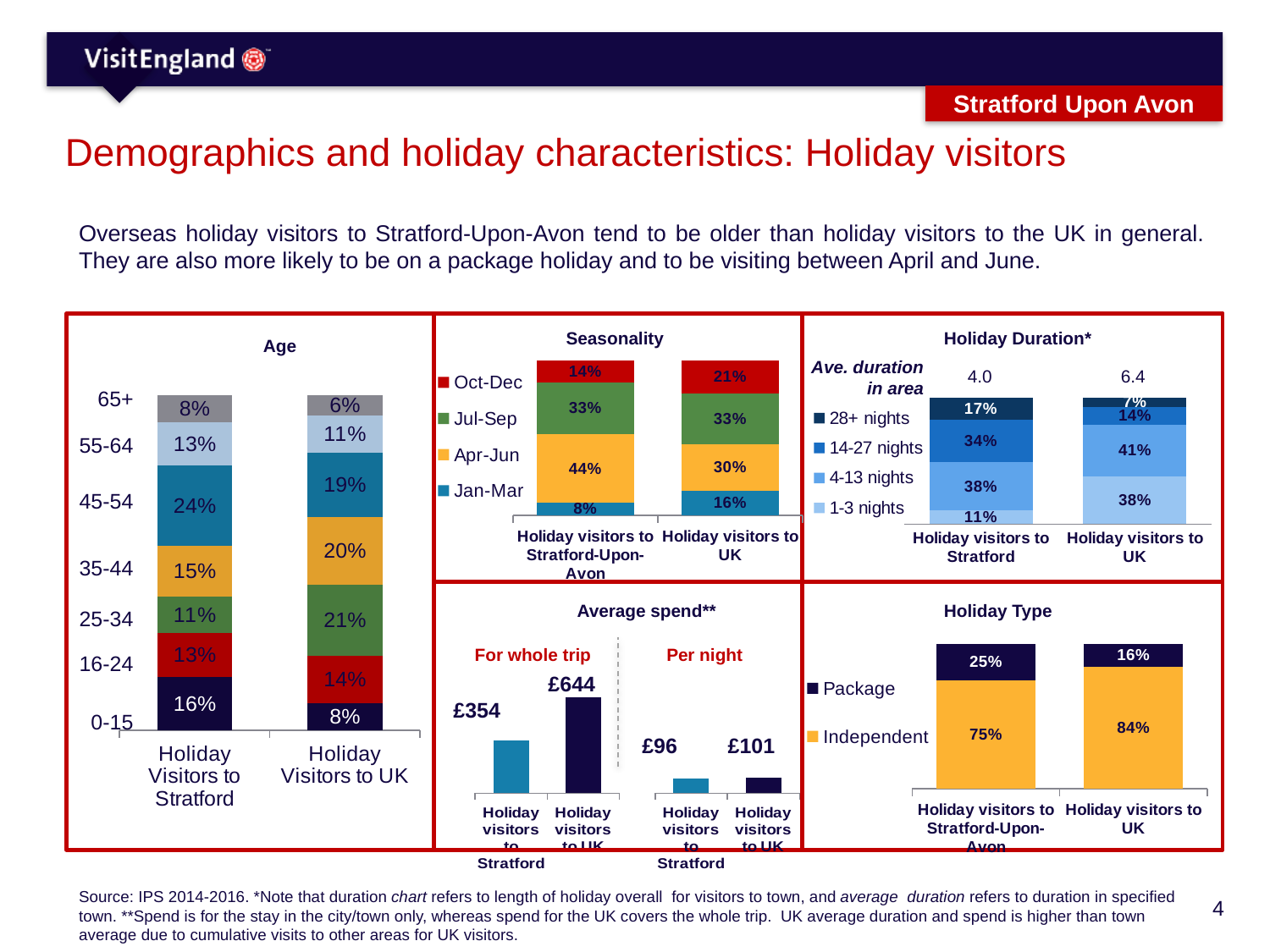
In the Average spend chart, which is larger: the per night spend for holiday visitors to Stratford or for holiday visitors to the UK? Holiday visitors to UK In the Average spend chart, what is the average spend for the whole trip for holiday visitors to the UK? £644 In the Holiday Type chart, what is the difference between the Independent share for holiday visitors to the UK and for holiday visitors to Stratford-Upon-Avon? 9% In the Holiday Duration chart, what share of holiday visitors to the UK stay 4-13 nights? 41% In the Seasonality chart, what share of holiday visitors to Stratford-Upon-Avon visit in Apr-Jun? 44% In the Holiday Duration chart, what is the difference between the 28+ nights share for holiday visitors to Stratford and for holiday visitors to the UK? 10% In the Seasonality chart, how many series does the legend list? 4 What kind of chart is the Age chart? Stacked bar chart In the Seasonality chart, which quarter has the largest share for holiday visitors to Stratford-Upon-Avon? Apr-Jun In the Holiday Type chart, what share of holiday visitors to Stratford-Upon-Avon are on a package holiday? 25% In the Holiday Duration chart, what is the average duration in area for holiday visitors to Stratford? 4.0 In the Seasonality chart, what share of holiday visitors to the UK visit in Jan-Mar? 16%